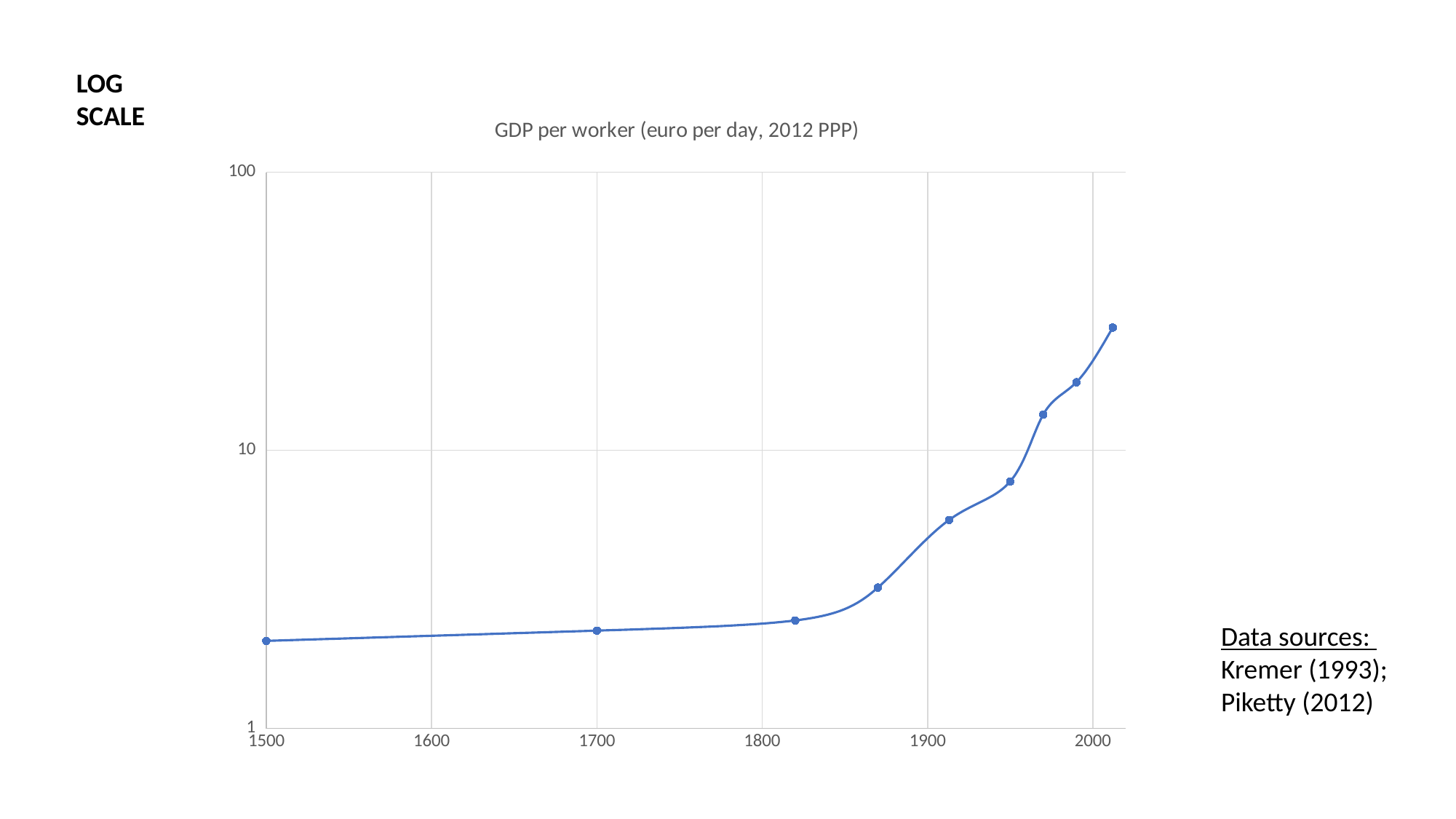
What kind of chart is shown on the slide? line chart Which point on the line has the highest value, the leftmost or the rightmost? the rightmost Is the value for the year 1500 greater or less than 10? less Do the values in the chart rise or fall as the years increase from 1500 to 2000? rise How many data points are marked on the line? 9 What is the title of the chart? GDP per worker (euro per day, 2012 PPP) Is the value for the year 1700 greater or less than 10? less What kind of scale is used on the vertical axis of the chart? log scale